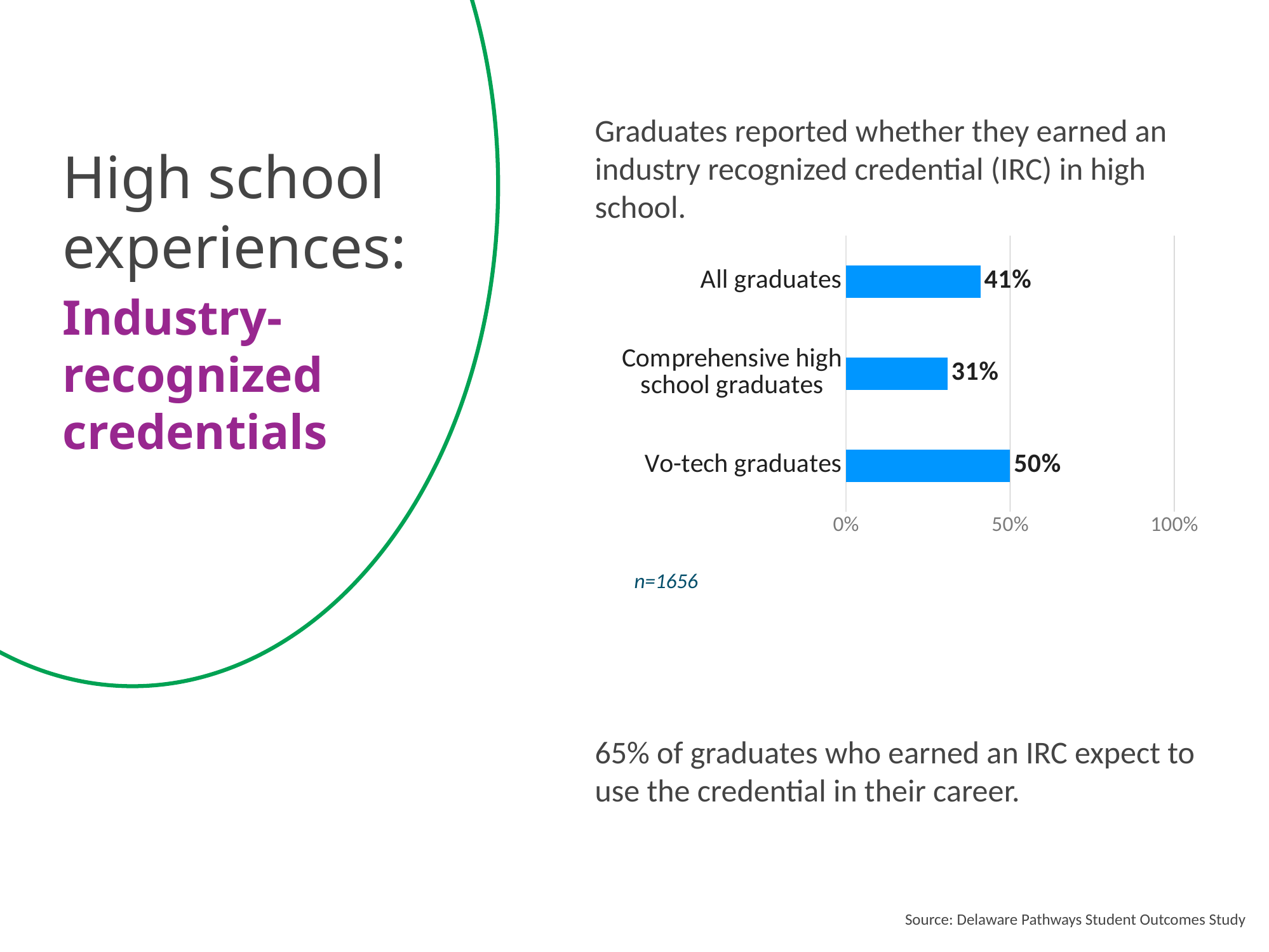
What percentage of vo-tech graduates earned an IRC? 50% Is the value for all graduates greater or less than 50%? less What percentage of all graduates earned an industry recognized credential in high school? 41% Which group has the highest percentage of graduates earning an IRC? Vo-tech graduates What is the difference in percentage points between all graduates and comprehensive high school graduates earning an IRC? 10 Which is larger: the percentage for all graduates or for comprehensive high school graduates? All graduates What is the sample size (n) noted below the chart? n=1656 What kind of chart is shown on the slide? Bar chart What is the difference in percentage points between vo-tech graduates and comprehensive high school graduates earning an IRC? 19 How many groups are shown in the chart? 3 What percentage of comprehensive high school graduates earned an IRC? 31% Which group has the lowest percentage of graduates earning an IRC? Comprehensive high school graduates